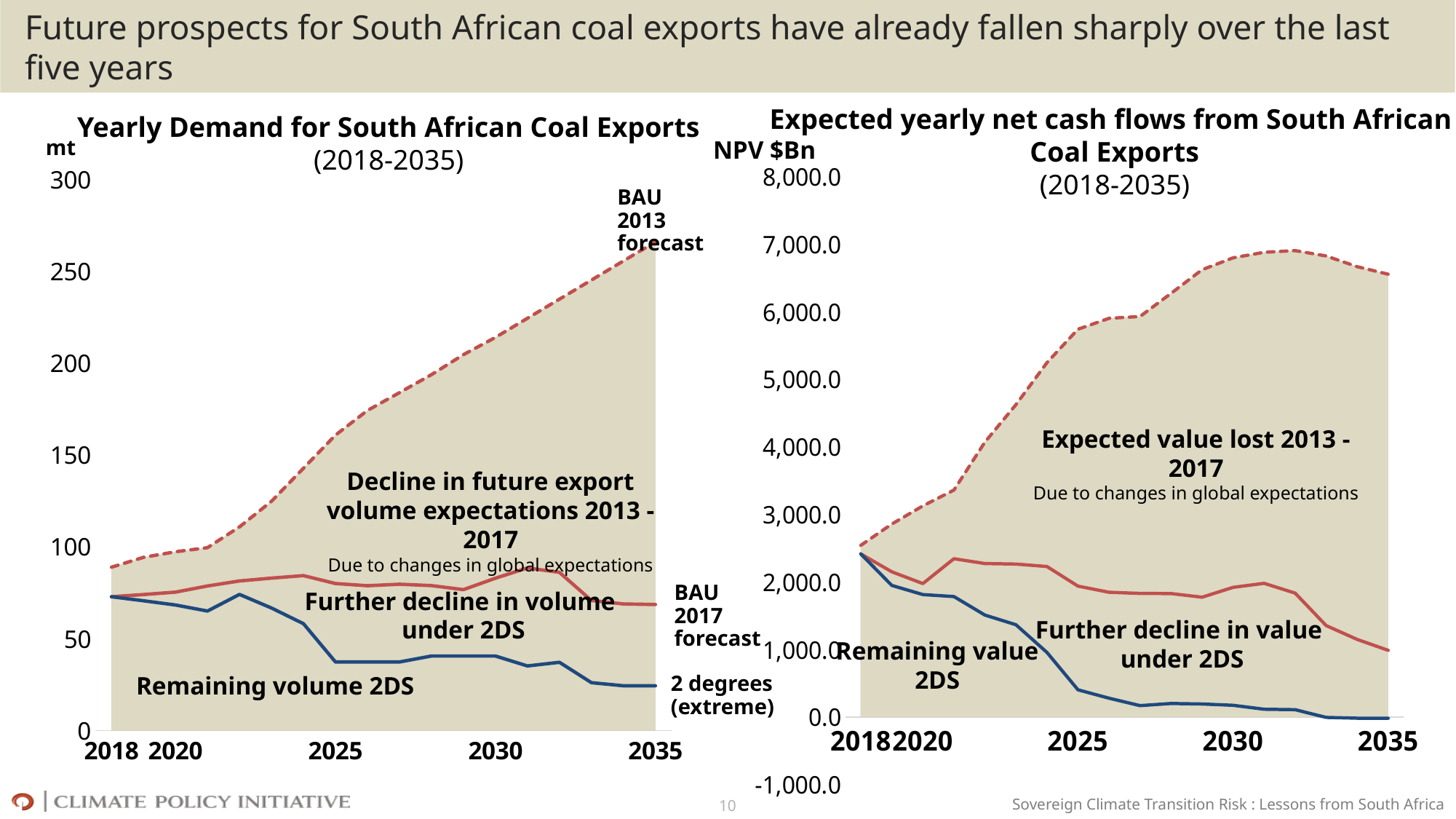
In the 'Yearly Demand for South African Coal Exports' chart, is the BAU 2013 forecast value in 2035 greater or less than 250? greater What kind of chart is the 'Expected yearly net cash flows from South African Coal Exports' chart on the right? area and line chart In the 'Expected yearly net cash flows from South African Coal Exports' chart, is the 2 degrees (extreme) value in 2035 greater or less than 1,000.0? less In the 'Yearly Demand for South African Coal Exports' chart, does the BAU 2013 forecast line rise or fall from 2018 to 2035? rise What kind of chart is the 'Yearly Demand for South African Coal Exports' chart on the left? area and line chart How many lines are plotted in the 'Yearly Demand for South African Coal Exports' chart? 3 In the 'Expected yearly net cash flows from South African Coal Exports' chart, does the dashed BAU 2013 forecast line rise or fall from 2018 to 2035? rise In the 'Yearly Demand for South African Coal Exports' chart, is the BAU 2017 forecast value in 2035 greater or less than 100? less In the 'Yearly Demand for South African Coal Exports' chart, does the 2 degrees (extreme) line rise or fall from 2018 to 2035? fall What unit is shown on the vertical axis of the 'Expected yearly net cash flows from South African Coal Exports' chart? NPV $Bn